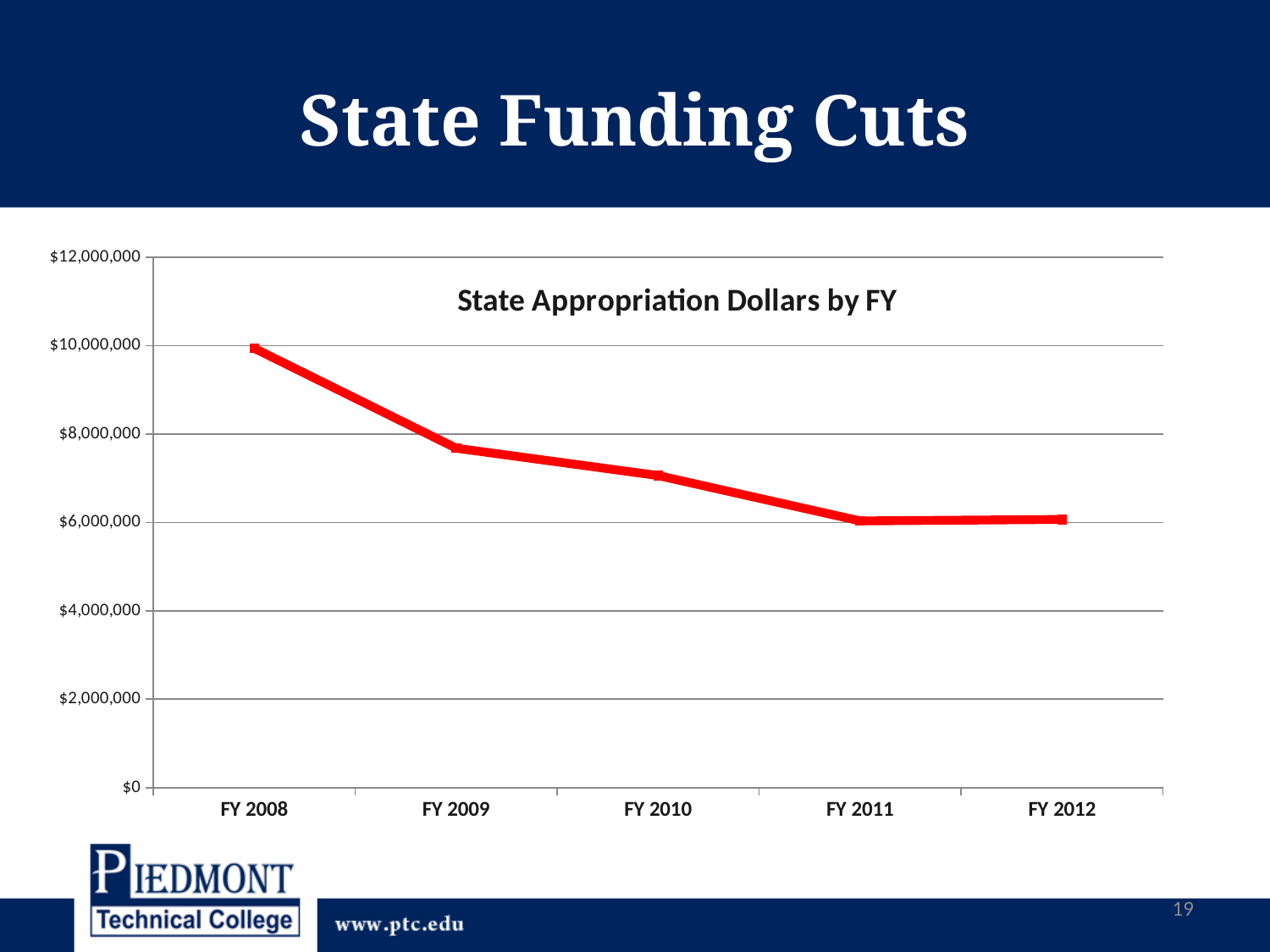
What type of chart is shown on the slide? Line chart How many fiscal years are plotted on the x axis? 5 Is the value for FY 2009 greater or less than $8,000,000? less Is the value for FY 2011 greater or less than $8,000,000? less Is the value for FY 2008 greater or less than $8,000,000? greater Which is larger, the value for FY 2009 or the value for FY 2010? FY 2009 What colour is the plotted line? Red What is the title of the chart? State Appropriation Dollars by FY Which is larger, the value for FY 2010 or the value for FY 2011? FY 2010 Do state appropriation dollars generally rise or fall from FY 2008 to FY 2012? Fall Which fiscal year has the highest state appropriation dollars? FY 2008